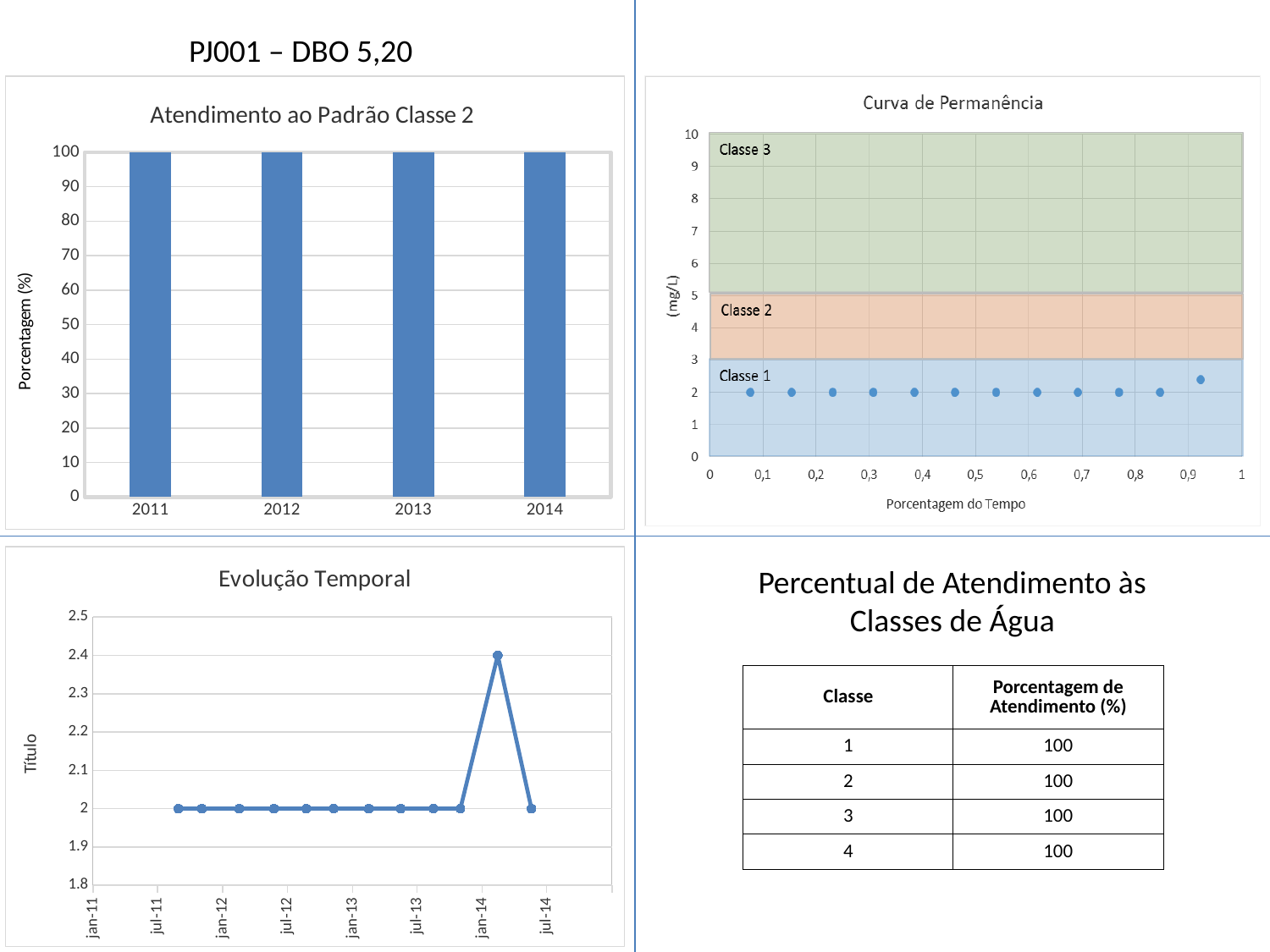
In the "Evolução Temporal" chart, what is the highest value reached by the line? 2.4 In the "Curva de Permanência" chart, is the value of the rightmost point greater or less than 3? less What kind of chart is "Atendimento ao Padrão Classe 2"? bar chart What is the y-axis label of the "Atendimento ao Padrão Classe 2" chart? Porcentagem (%) In the "Evolução Temporal" chart, what is the value of the first plotted point? 2 In the "Atendimento ao Padrão Classe 2" chart, what is the value for 2013? 100 In the "Atendimento ao Padrão Classe 2" chart, what is the difference between the values for 2011 and 2014? 0 How many points are plotted in the "Curva de Permanência" chart? 12 How many data points are plotted in the "Evolução Temporal" chart? 12 What kind of chart is "Evolução Temporal"? line chart What is the x-axis label of the "Curva de Permanência" chart? Porcentagem do Tempo How many years are shown in the "Atendimento ao Padrão Classe 2" chart? 4